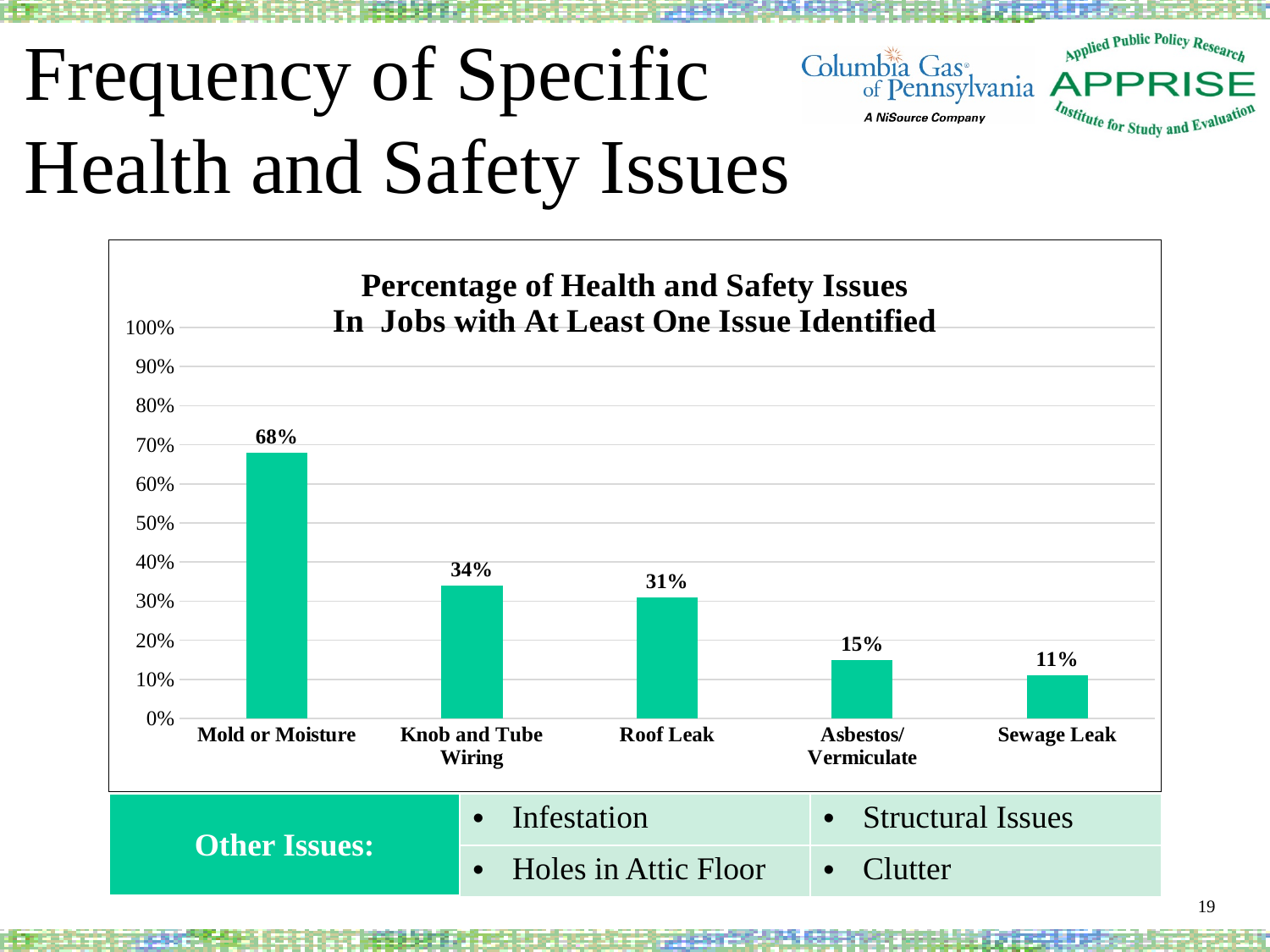
Which health and safety issue has the highest percentage? Mold or Moisture What percentage is shown for Sewage Leak? 11% Is the value for Asbestos/Vermiculate greater or less than 20%? less How many health and safety issue categories are plotted in the chart? 5 What percentage is shown for Knob and Tube Wiring? 34% What is the difference in percentage points between Asbestos/Vermiculate and Sewage Leak? 4 What percentage is shown for Mold or Moisture? 68% What is the difference in percentage points between Mold or Moisture and Roof Leak? 37 What is the title of the chart? Percentage of Health and Safety Issues In Jobs with At Least One Issue Identified Which is larger, the value for Knob and Tube Wiring or the value for Roof Leak? Knob and Tube Wiring What kind of chart is shown on the slide? bar chart Which health and safety issue has the lowest percentage? Sewage Leak